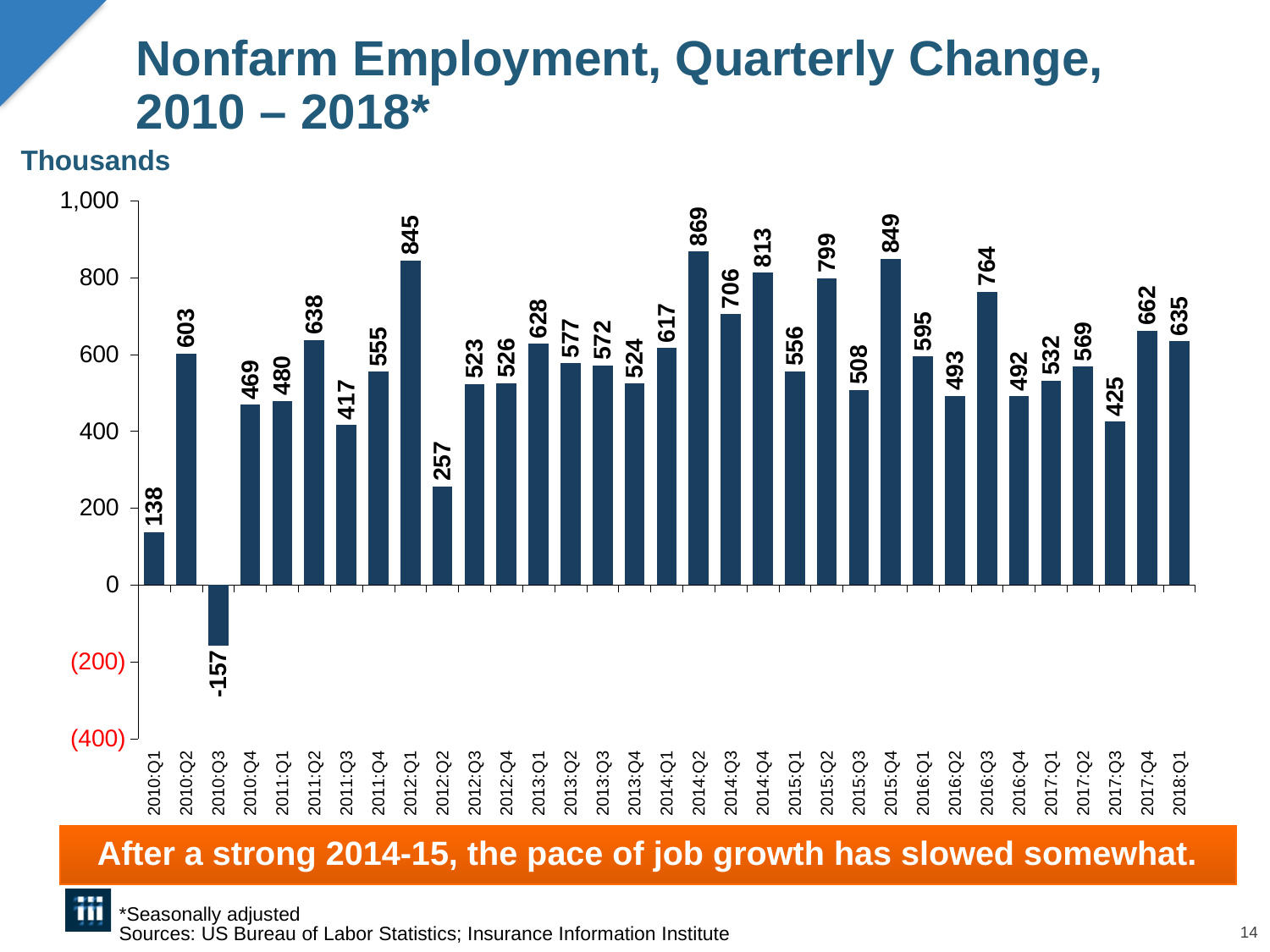
Do the values rise or fall from 2017:Q3 to 2017:Q4? rise How many quarters are plotted on the chart? 33 What is the value for 2014:Q2? 869 Which is larger, the value for 2015:Q4 or the value for 2016:Q3? 2015:Q4 What unit is stated above the chart's y axis? Thousands What is the value for 2010:Q3? -157 What is the value for 2018:Q1? 635 Which quarter has the highest value? 2014:Q2 What is the difference between the values for 2012:Q1 and 2012:Q2? 588 Is the value for 2017:Q3 greater or less than 600? less What kind of chart is shown on the slide? bar chart Which quarter has the lowest value? 2010:Q3